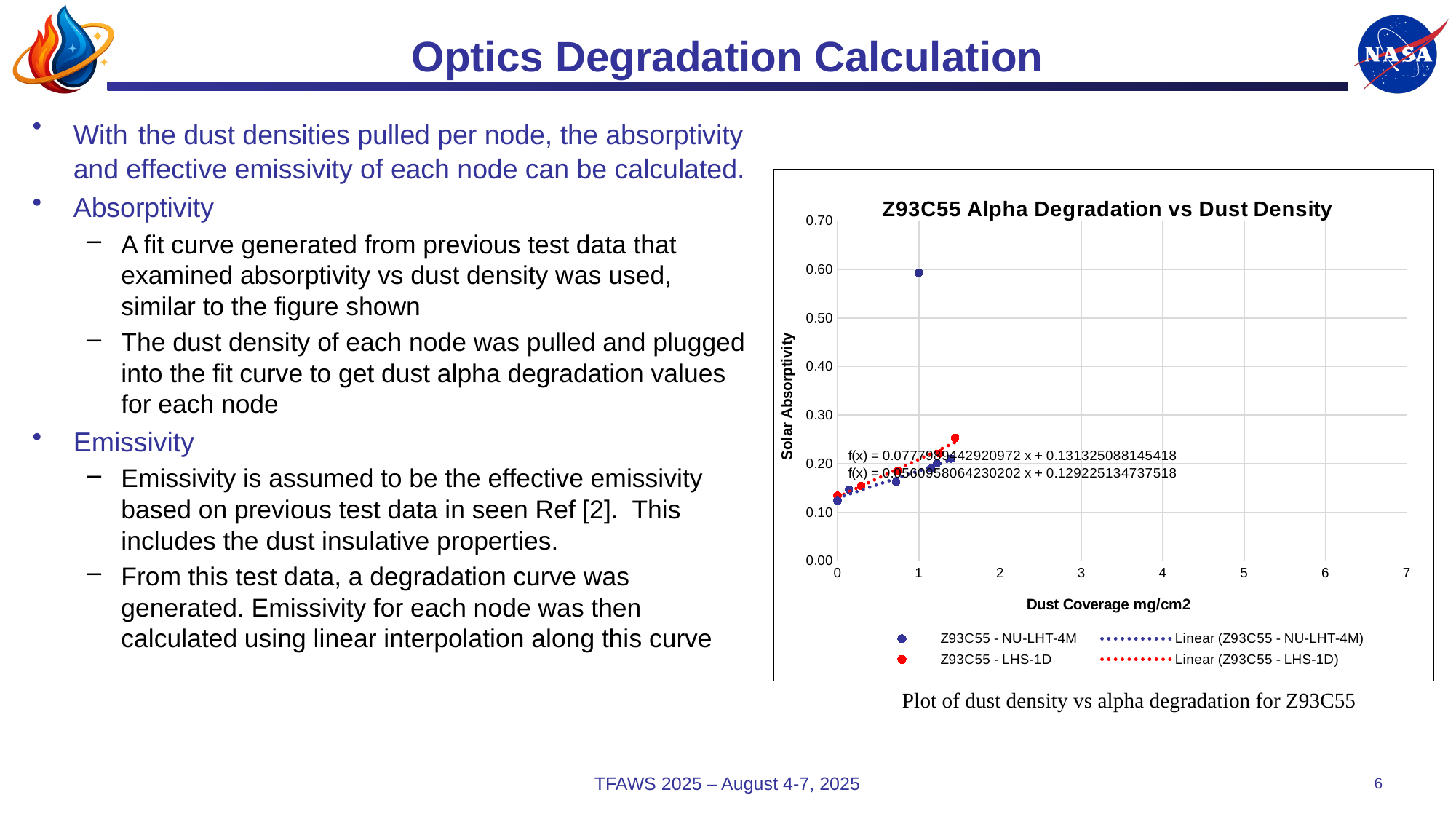
Is the highest plotted value for Z93C55 - LHS-1D greater or less than 0.30? less What kind of chart is shown on the slide? scatter chart What is the title of the chart on the slide? Z93C55 Alpha Degradation vs Dust Density How many entries does the chart legend list? 4 Do the solar absorptivity values generally rise or fall as dust coverage increases? rise What is the maximum value shown on the y axis of the chart? 0.70 Which series is plotted in red on the chart? Z93C55 - LHS-1D